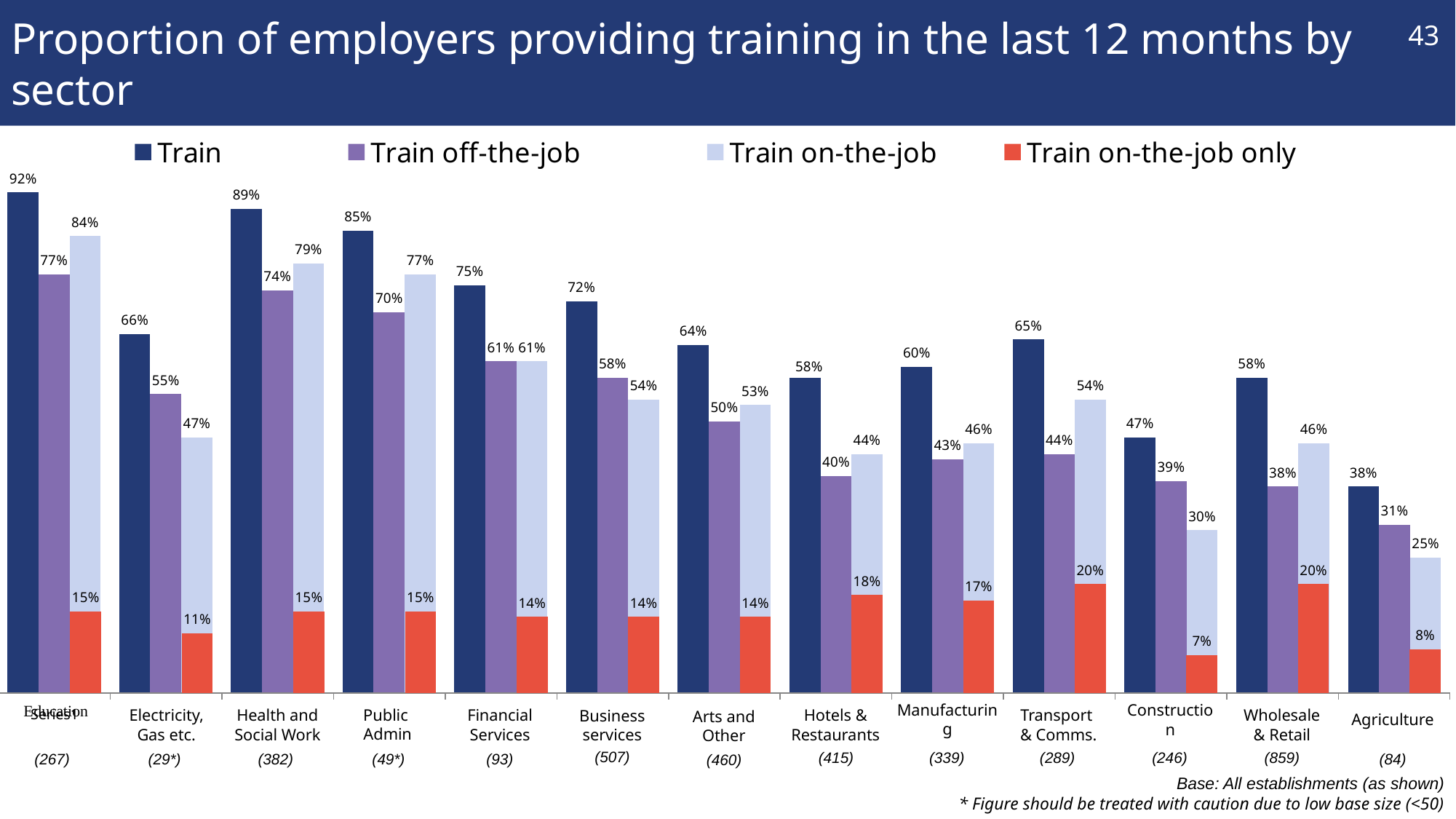
Which sector has the lowest "Train" value? Agriculture What is the "Train on-the-job" value for Wholesale & Retail? 46% Which colour represents the "Train on-the-job only" series in the legend? Red What is the difference between the "Train" value and the "Train on-the-job only" value for Transport & Comms.? 45% Which is larger for Construction: the "Train off-the-job" value or the "Train on-the-job" value? Train off-the-job How many sectors are shown on the x axis of the chart? 13 What is the "Train on-the-job only" value for Construction? 7% Which sector has the highest "Train on-the-job" value? Education What kind of chart is shown on the slide? Bar chart How many series does the legend list? 4 What is the "Train off-the-job" value for Hotels & Restaurants? 40% What percentage of employers in Education provide training (the "Train" series)? 92%